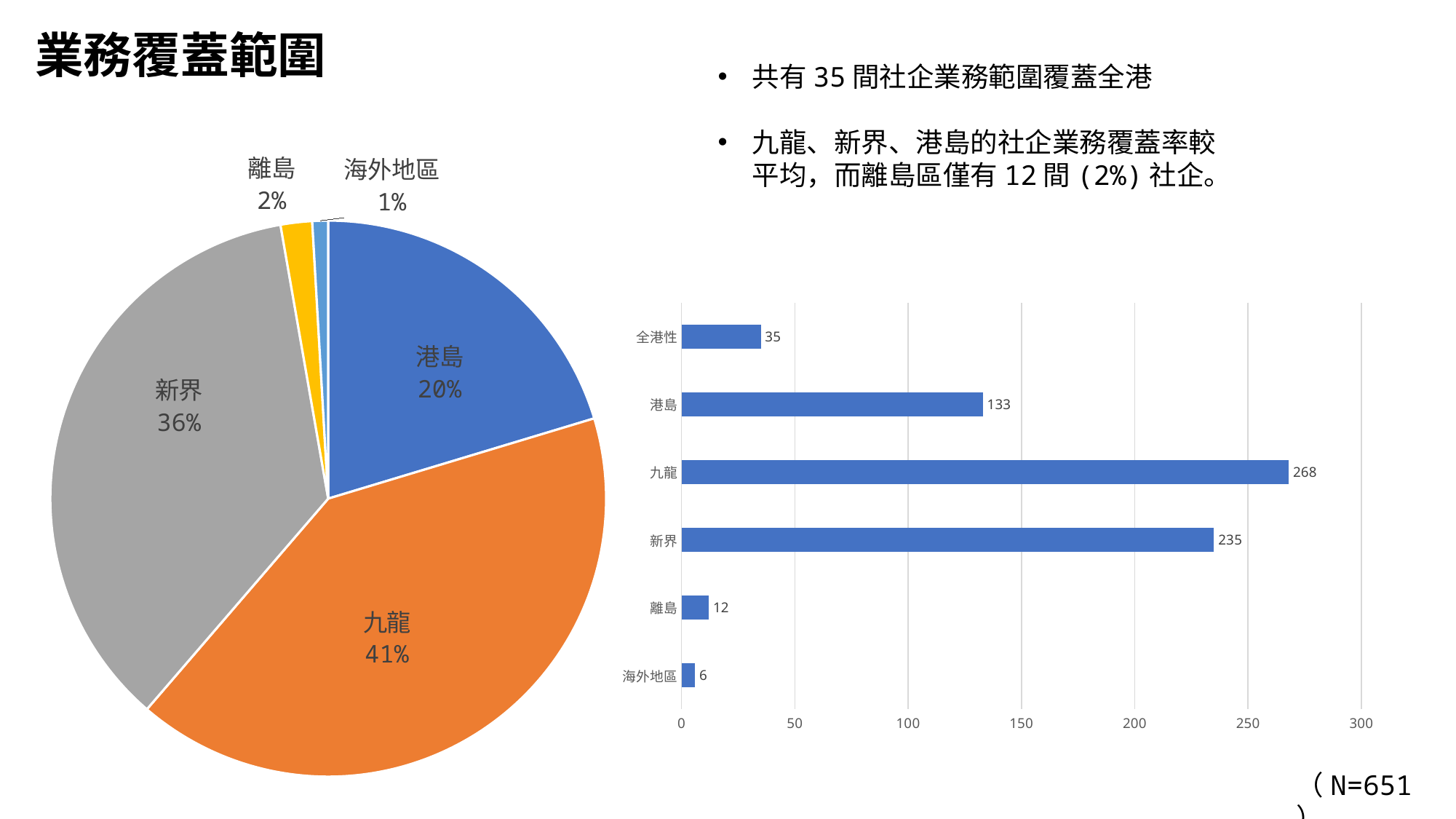
In the pie chart on the left, what share does 離島 have? 2% In the bar chart on the right, which category has the lowest value? 海外地區 In the bar chart on the right, what is the value for 海外地區? 6 In the bar chart on the right, what is the difference between the values for 九龍 and 新界? 33 In the bar chart on the right, what is the value for 九龍? 268 In the bar chart on the right, which is larger, the value for 全港性 or the value for 離島? 全港性 In the bar chart on the right, what is the value for 港島? 133 In the pie chart on the left, what share does 新界 have? 36% In the bar chart on the right, how many categories are shown? 6 In the pie chart on the left, which slice is the largest? 九龍 What kind of chart is on the right side of the slide? Bar chart In the bar chart on the right, which category has the highest value? 九龍